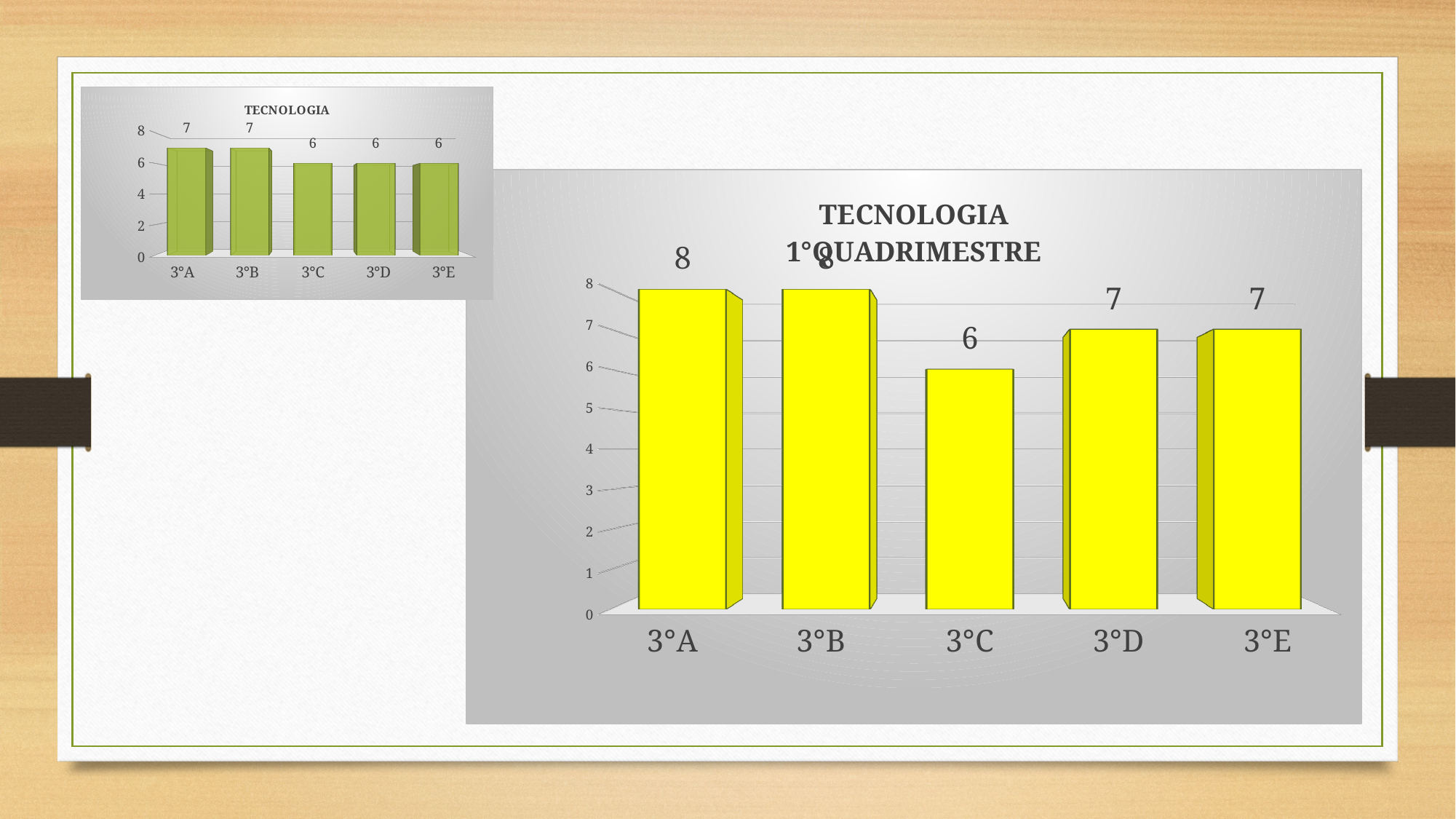
In the 'TECNOLOGIA 1°QUADRIMESTRE' chart, what is the value for 3°A? 8 In the 'TECNOLOGIA 1°QUADRIMESTRE' chart, what is the difference between the values for 3°A and 3°C? 2 In the small 'TECNOLOGIA' chart at the top left, what is the value for 3°B? 7 What colour are the bars in the 'TECNOLOGIA 1°QUADRIMESTRE' chart? Yellow In the 'TECNOLOGIA 1°QUADRIMESTRE' chart, what is the value for 3°E? 7 What kind of chart is the 'TECNOLOGIA 1°QUADRIMESTRE' chart? Bar chart In the 'TECNOLOGIA 1°QUADRIMESTRE' chart, which category has the lowest value? 3°C In the 'TECNOLOGIA 1°QUADRIMESTRE' chart, which is larger, the value for 3°B or the value for 3°D? 3°B In the small 'TECNOLOGIA' chart at the top left, what is the difference between the values for 3°A and 3°E? 1 How many categories are shown in the 'TECNOLOGIA 1°QUADRIMESTRE' chart? 5 In the 'TECNOLOGIA 1°QUADRIMESTRE' chart, what is the value for 3°C? 6 In the small 'TECNOLOGIA' chart at the top left, what is the value for 3°D? 6